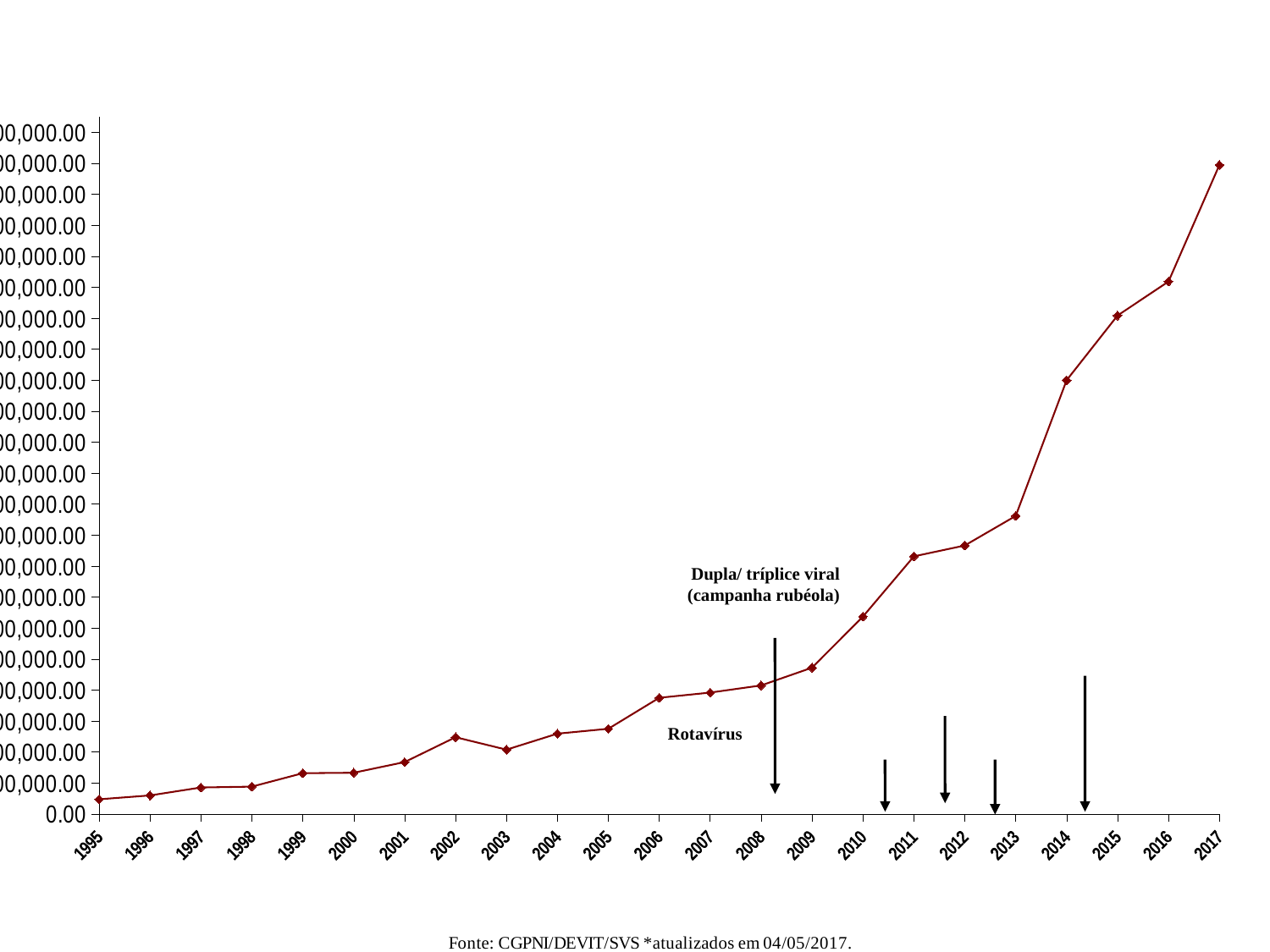
Which year has the larger value, 2002 or 2003? 2002 Do the values generally rise or fall from 1995 to 2017? rise Which year has the larger value, 2008 or 2010? 2010 What kind of chart is shown on the slide? line chart How many years are plotted along the x axis of the chart? 23 Which year has the highest value on the chart? 2017 Which year has the larger value, 2013 or 2014? 2014 What is the first year shown on the x axis? 1995 Which year has the lowest value on the chart? 1995